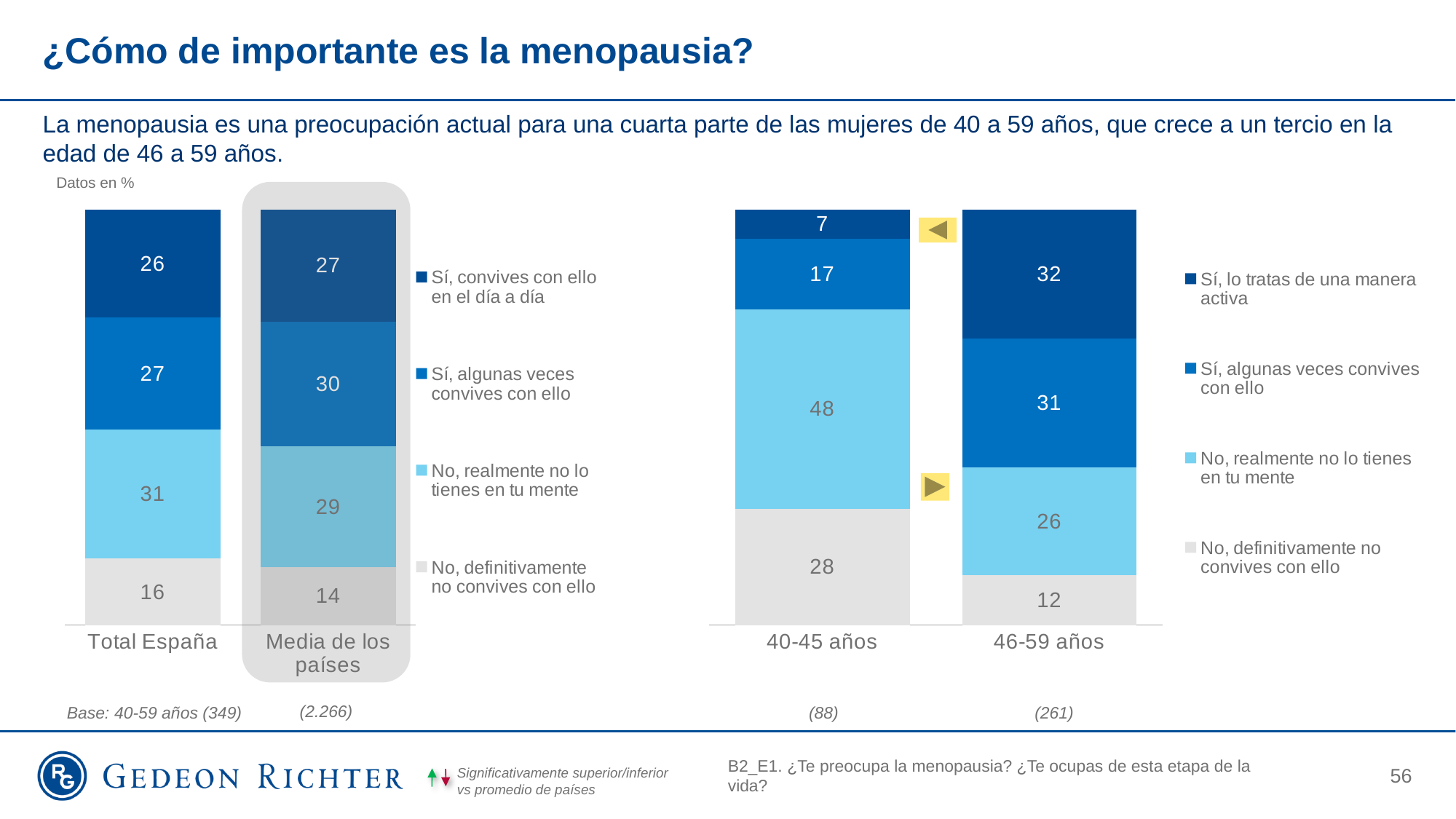
In the left chart, what is the value for "No, realmente no lo tienes en tu mente" for Total España? 31 In the left chart, which category has the higher value for "Sí, algunas veces convives con ello"? Media de los países In the right chart, what is the value for "No, realmente no lo tienes en tu mente" for 40-45 años? 48 How many categories are shown on the x axis of the left chart? 2 What kind of chart is the left chart? Stacked bar chart In the right chart, which segment of the 40-45 años bar is the smallest? Sí, lo tratas de una manera activa In the right chart, which age group has the larger value for "No, definitivamente no convives con ello"? 40-45 años In the left chart, what is the value for "Sí, algunas veces convives con ello" for Media de los países? 30 In the right chart, what is the value for "Sí, lo tratas de una manera activa" for 46-59 años? 32 How many series does the legend of the right chart list? 4 In the left chart, what is the difference between the "No, definitivamente no convives con ello" values for Total España and Media de los países? 2 In the right chart, what is the difference between the "Sí, lo tratas de una manera activa" values for 46-59 años and 40-45 años? 25